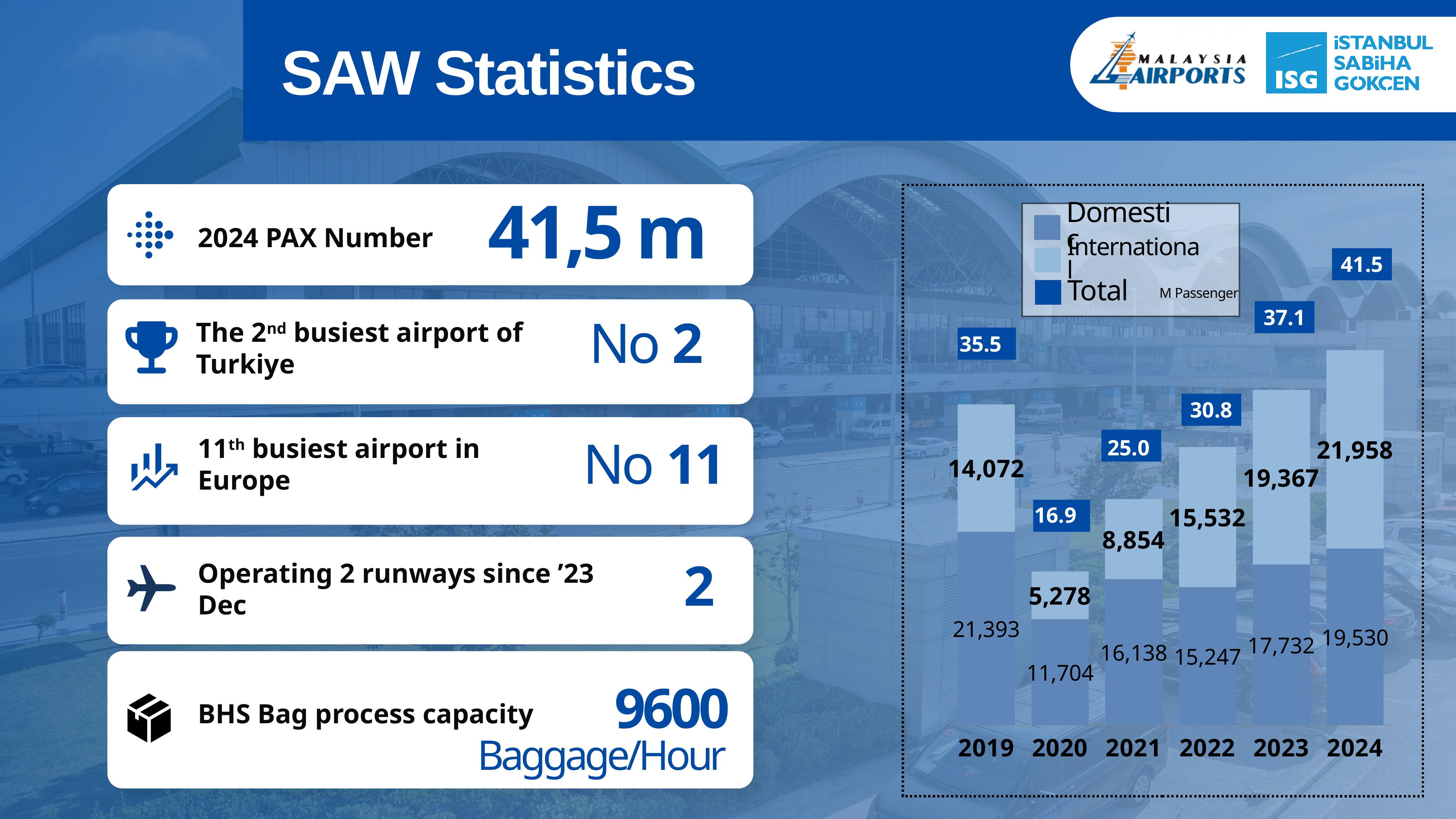
What is the difference between the International and Domestic values for 2024? 2,428 In 2023, which is larger, the Domestic or the International value? International What total (M Passenger) is labelled for 2022? 30.8 What is the International value for 2024? 21,958 Which year has the highest total passengers? 2024 How many entries does the chart legend list? 3 What kind of chart is shown on the slide? Stacked bar chart Which year has the lowest total passengers? 2020 Which year has the highest Domestic value? 2019 How many years are shown on the x axis of the chart? 6 What is the Domestic value for 2019? 21,393 What is the difference between the Domestic values for 2019 and 2020? 9,689